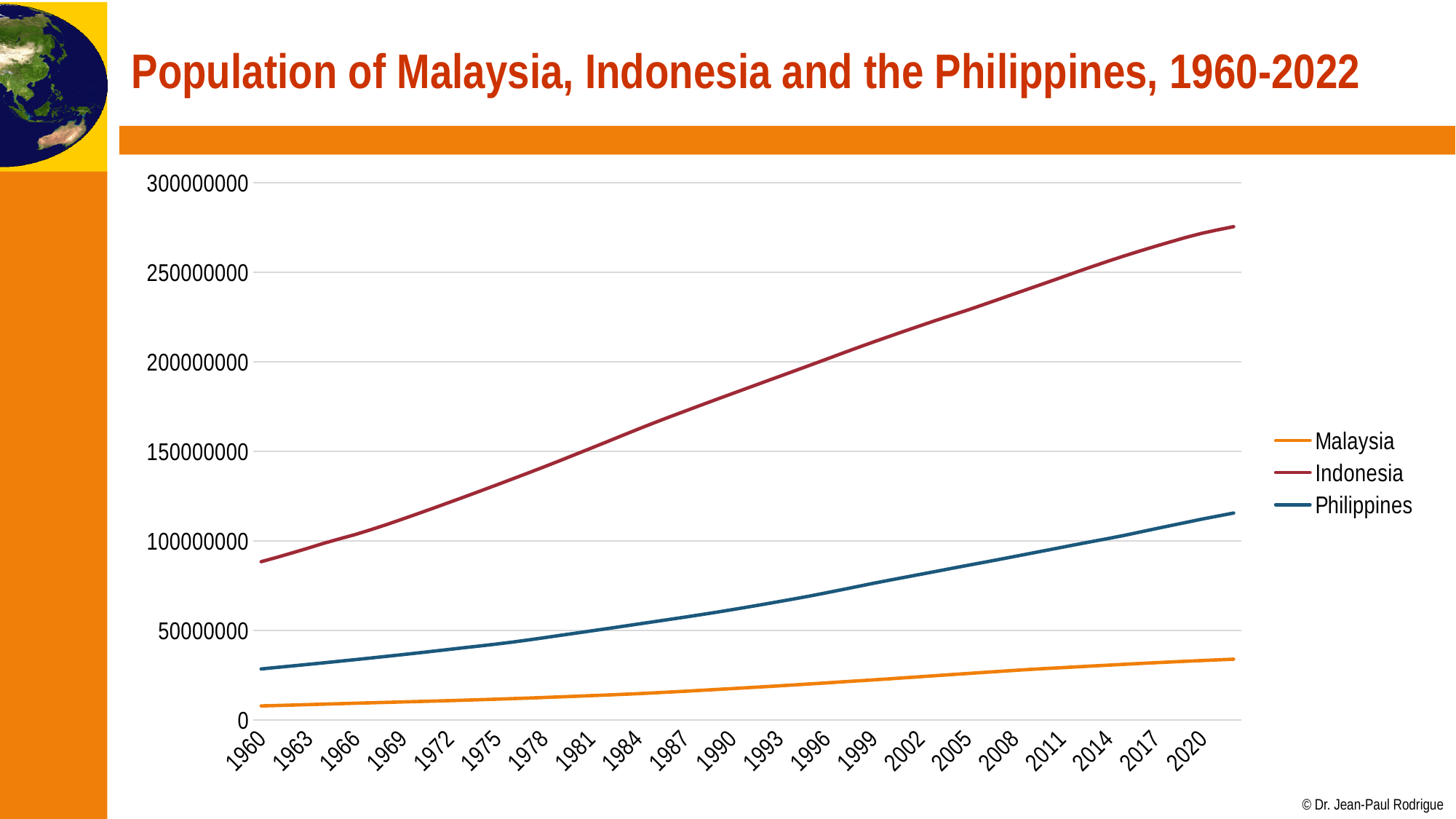
Which country has the lowest population throughout the period shown? Malaysia How many year labels are shown on the x axis? 21 In 1990, which is larger, the population of the Philippines or the population of Malaysia? Philippines Is the population of Indonesia in 1960 greater or less than 100000000? less Is the population of the Philippines in 2020 greater or less than 100000000? greater What kind of chart is shown on the slide? line chart Is the population of Indonesia in 2020 greater or less than 250000000? greater Which country has the highest population throughout the period shown? Indonesia What colour is the line for Indonesia? red How many series does the legend list? 3 Does the population of Indonesia rise or fall from 1960 to 2022? rise